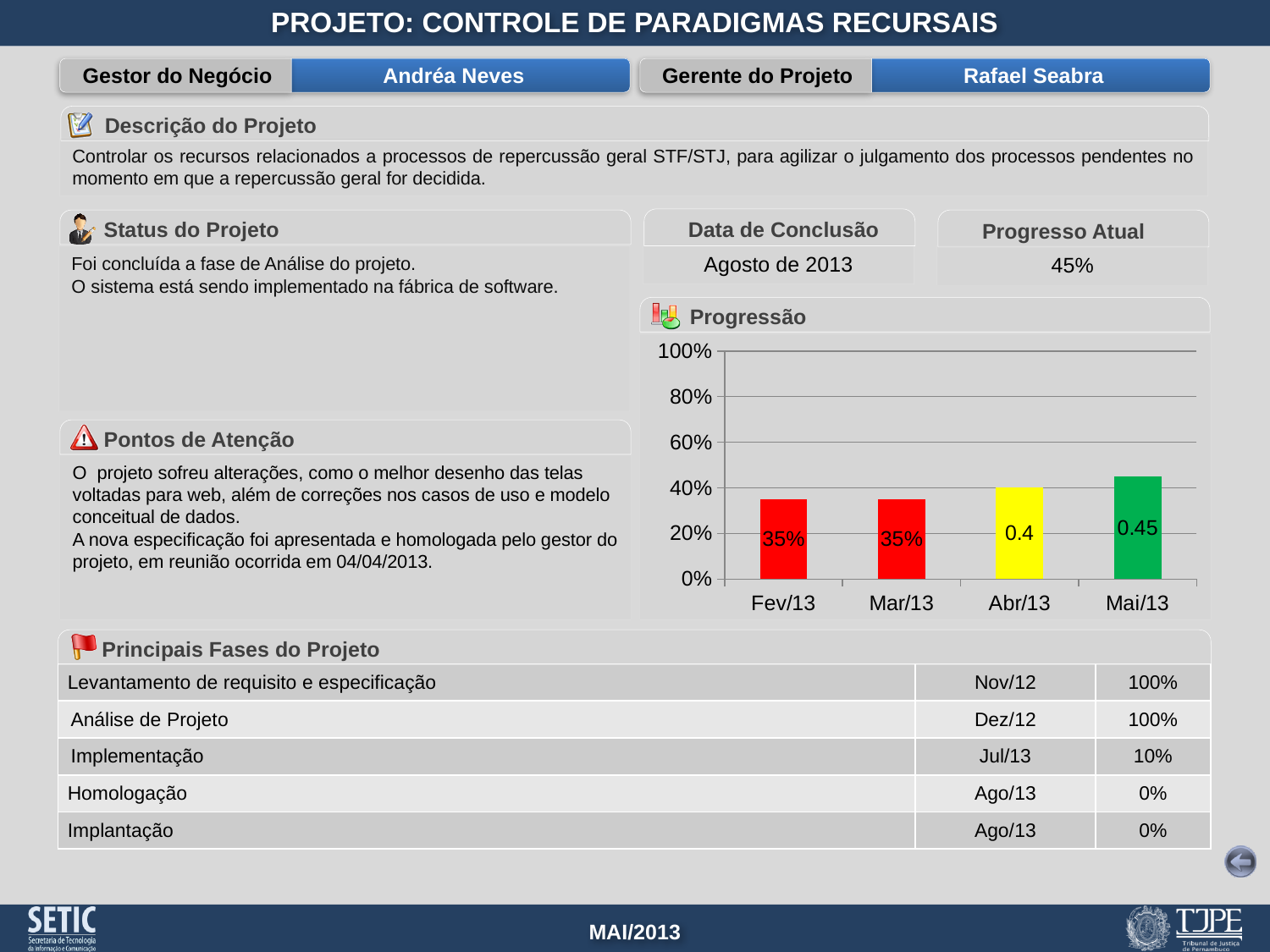
How many months are plotted in the Progressão chart? 4 What is the value shown for Mar/13 in the Progressão chart? 35% In the Progressão chart, is the value for Fev/13 greater or less than 40%? less What is the value shown for Fev/13 in the Progressão chart? 35% What colour is the Abr/13 bar in the Progressão chart? yellow What data label is printed on the Abr/13 bar in the Progressão chart? 0.4 In the Progressão chart, which is larger, the value for Mai/13 or the value for Fev/13? Mai/13 What kind of chart is the Progressão chart? bar chart Which month has the highest bar in the Progressão chart? Mai/13 In the Progressão chart, is the value for Mai/13 greater or less than 40%? greater What data label is printed on the Mai/13 bar in the Progressão chart? 0.45 Do the values in the Progressão chart rise or fall from Fev/13 to Mai/13? rise